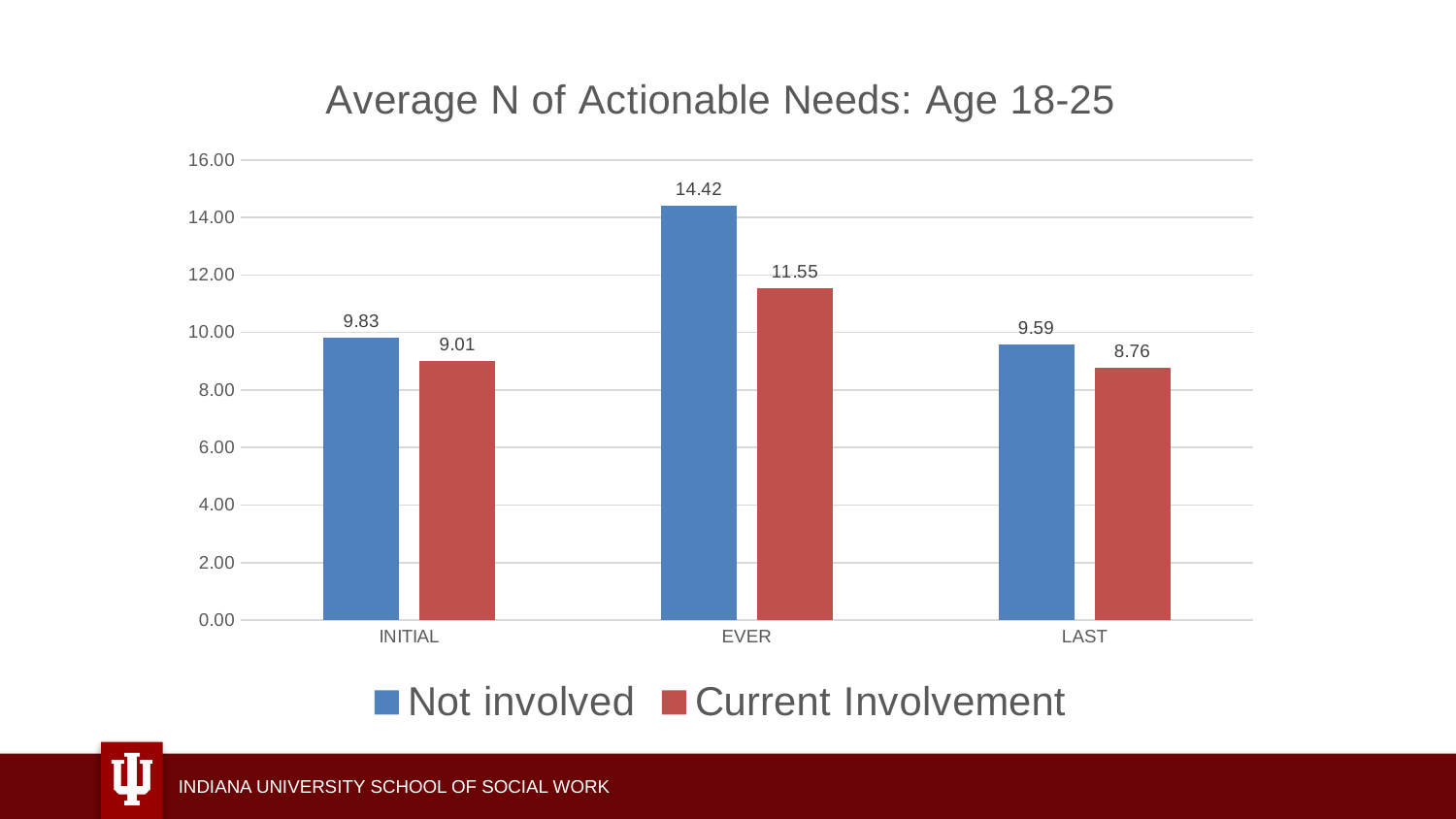
What kind of chart is shown? bar chart Is the value for Current Involvement at EVER greater or less than 10.00? greater How many categories are shown on the x axis? 3 What is the value for Current Involvement at LAST? 8.76 What is the title of the chart? Average N of Actionable Needs: Age 18-25 Which is larger at INITIAL, Not involved or Current Involvement? Not involved Which category has the highest value for Not involved? EVER What is the value for Not involved at EVER? 14.42 What is the difference between Not involved and Current Involvement at EVER? 2.87 Which category has the lowest value for Current Involvement? LAST What is the value for Current Involvement at INITIAL? 9.01 How many series does the legend list? 2